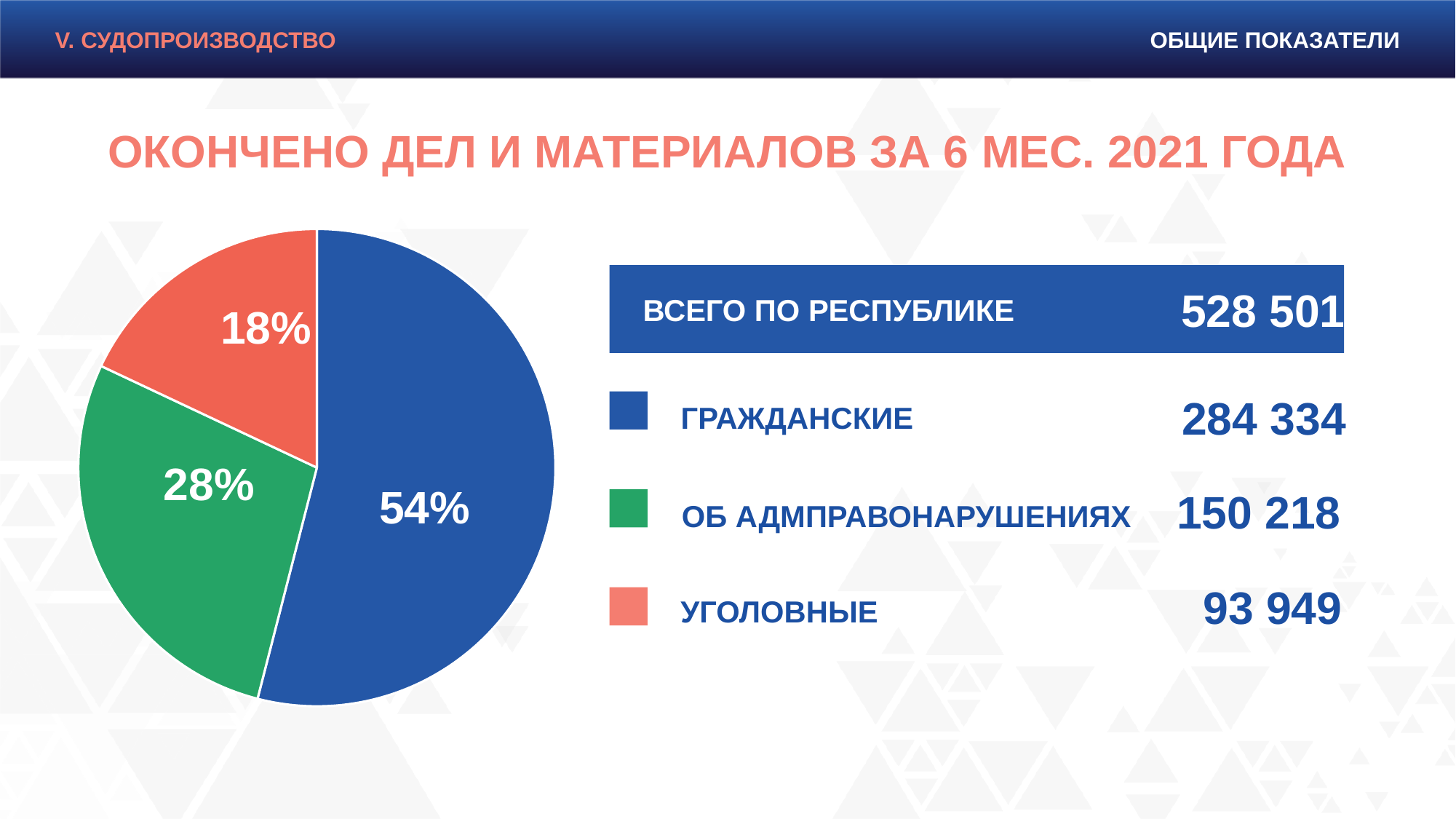
What share of the pie does the ГРАЖДАНСКИЕ slice represent? 54% What share of the pie does the ОБ АДМПРАВОНАРУШЕНИЯХ slice represent? 28% What colour is the slice for ОБ АДМПРАВОНАРУШЕНИЯХ? green What is the total number of cases shown for ВСЕГО ПО РЕСПУБЛИКЕ? 528 501 What kind of chart is shown on the slide? pie chart How many slices does the pie chart have? 3 Which category has the largest slice of the pie? ГРАЖДАНСКИЕ Which is larger, the share for ОБ АДМПРАВОНАРУШЕНИЯХ or the share for УГОЛОВНЫЕ? ОБ АДМПРАВОНАРУШЕНИЯХ Which category has the smallest slice of the pie? УГОЛОВНЫЕ What is the number of cases for ГРАЖДАНСКИЕ? 284 334 What is the number of cases for УГОЛОВНЫЕ? 93 949 What share of the pie does the УГОЛОВНЫЕ slice represent? 18%